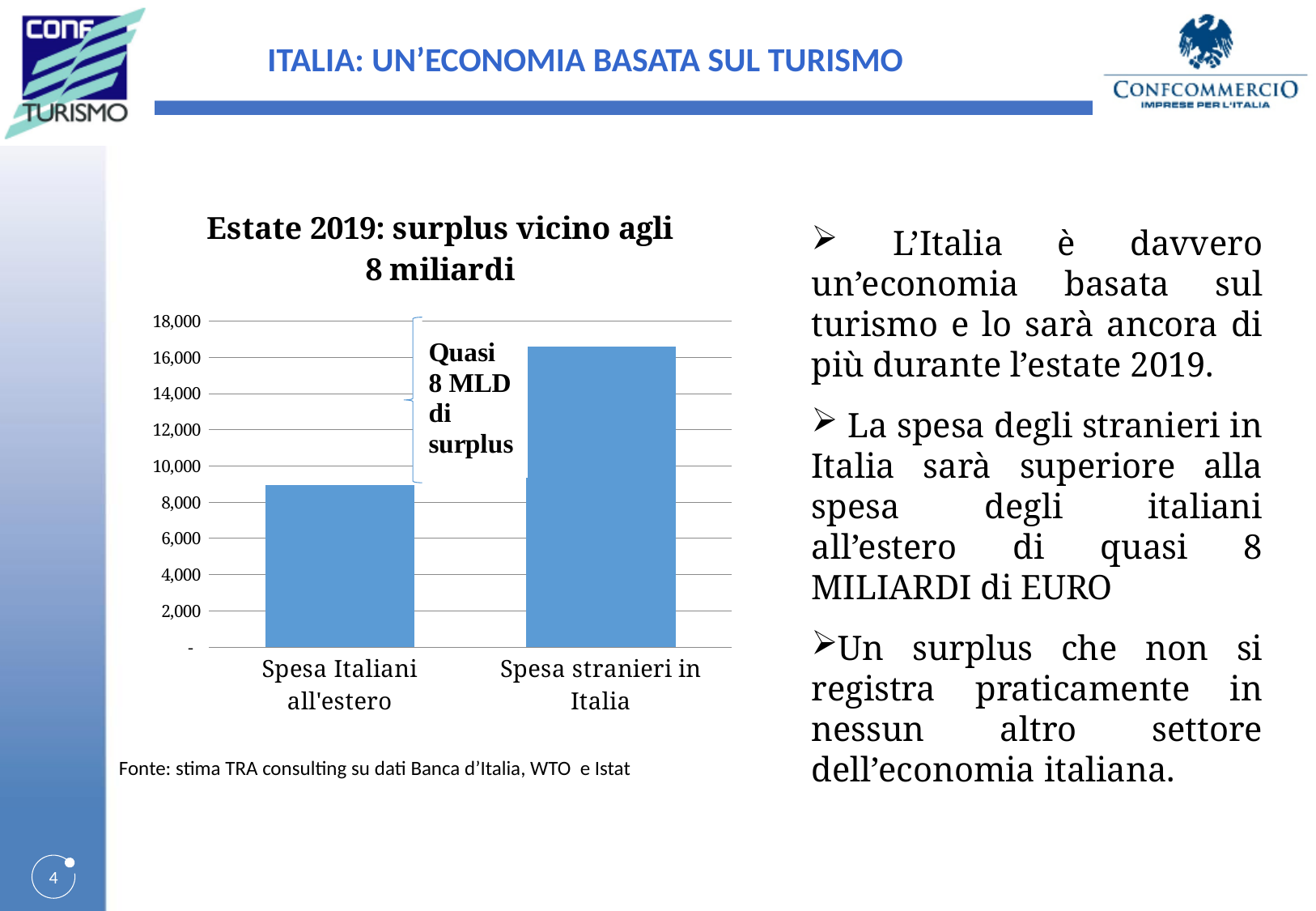
Is the value for Spesa Italiani all'estero greater or less than 10,000? less Which is larger, the value for Spesa Italiani all'estero or the value for Spesa stranieri in Italia? Spesa stranieri in Italia Is the value for Spesa stranieri in Italia greater or less than 18,000? less Is the value for Spesa Italiani all'estero greater or less than 8,000? greater What is the title of the chart? Estate 2019: surplus vicino agli 8 miliardi What does the annotation between the two bars say? Quasi 8 MLD di surplus How many categories are plotted in the chart? 2 Which category has the lowest value in the chart? Spesa Italiani all'estero Which category has the highest value in the chart? Spesa stranieri in Italia What kind of chart is shown on the slide? bar chart